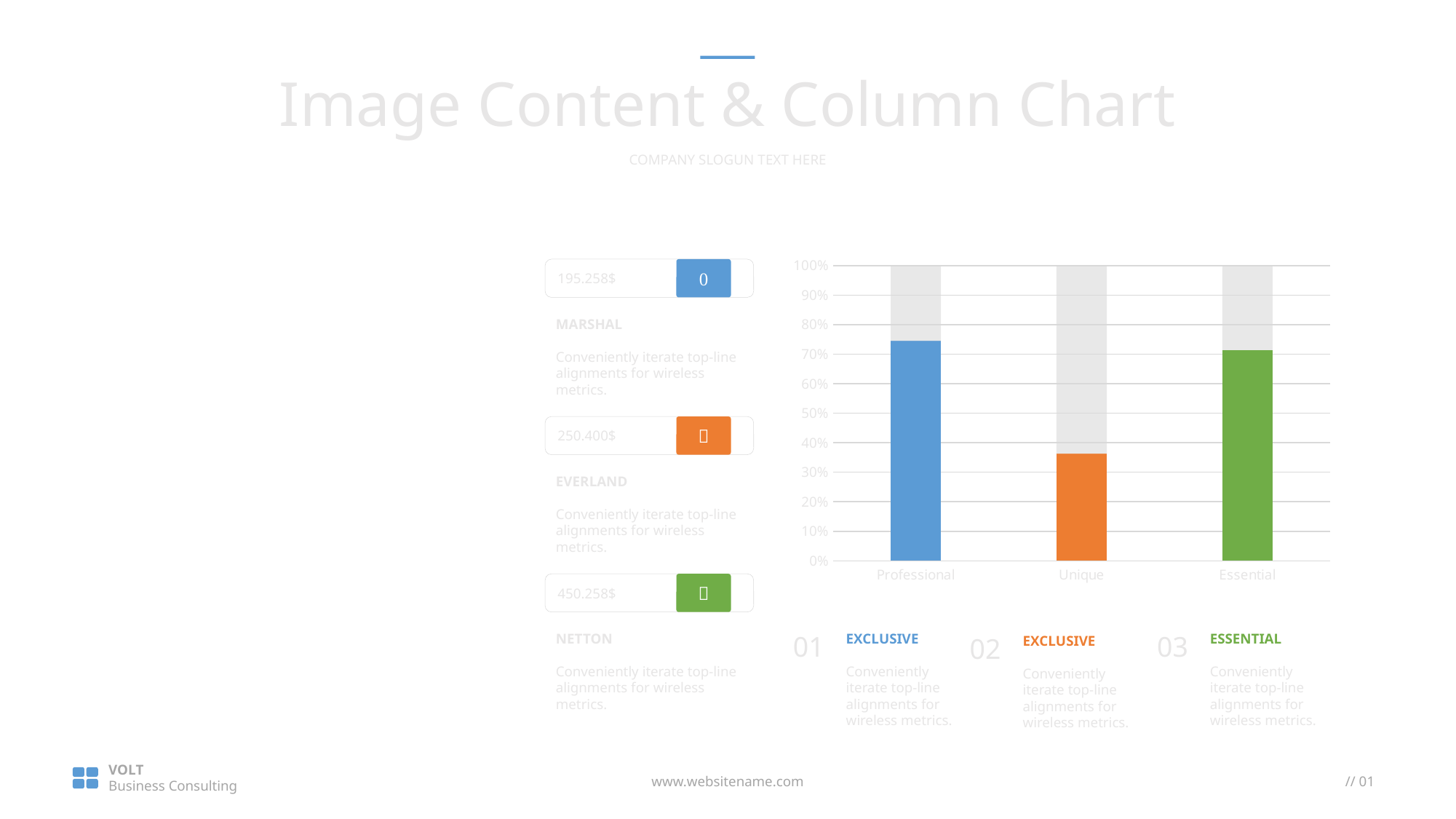
Which category has the lowest value on the chart? Unique Which is larger, the value for Professional or the value for Unique? Professional What kind of chart is shown on the slide? bar chart What colour is the bar for Unique? orange How many categories are plotted on the chart? 3 Which is larger, the value for Essential or the value for Unique? Essential What is the title of the slide containing the chart? Image Content & Column Chart Is the value for Essential greater or less than 60%? greater Is the value for Professional greater or less than 80%? less Is the value for Unique greater or less than 30%? greater